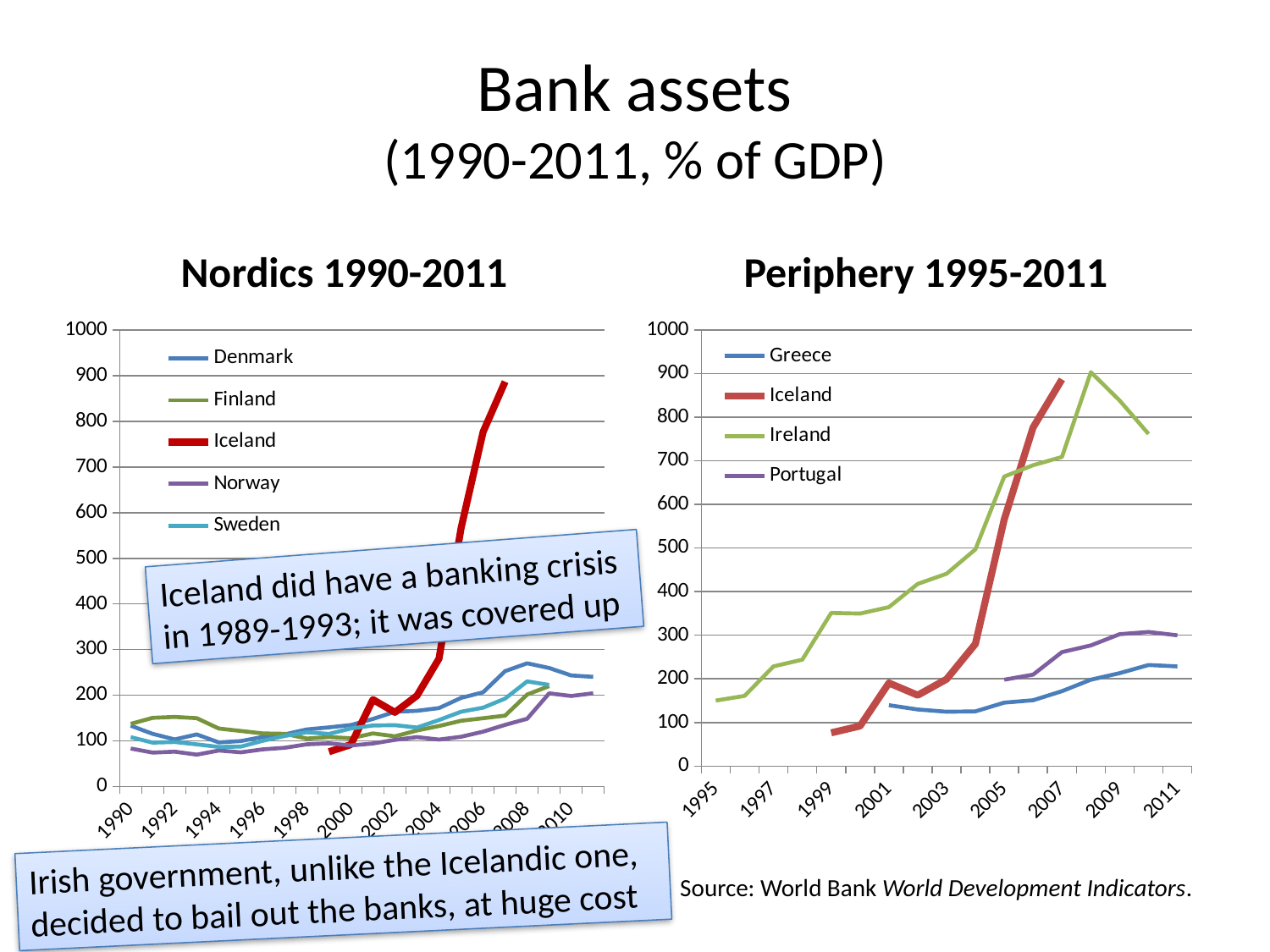
What type of chart is the Nordics 1990-2011 chart? line chart In the Periphery 1995-2011 chart, is the value for Greece in 2003 greater or less than 200? less In the Periphery 1995-2011 chart, which series has the highest value in 2011? Portugal How many series does the legend of the Nordics 1990-2011 chart list? 5 In the Periphery 1995-2011 chart, which series has the lowest value in 2011? Greece In the Nordics 1990-2011 chart, is the value for Iceland in 2007 greater or less than 800? greater In the Nordics 1990-2011 chart, which series has the highest value in 2007? Iceland How many series does the legend of the Periphery 1995-2011 chart list? 4 Which series is drawn in red in the Periphery 1995-2011 chart? Iceland